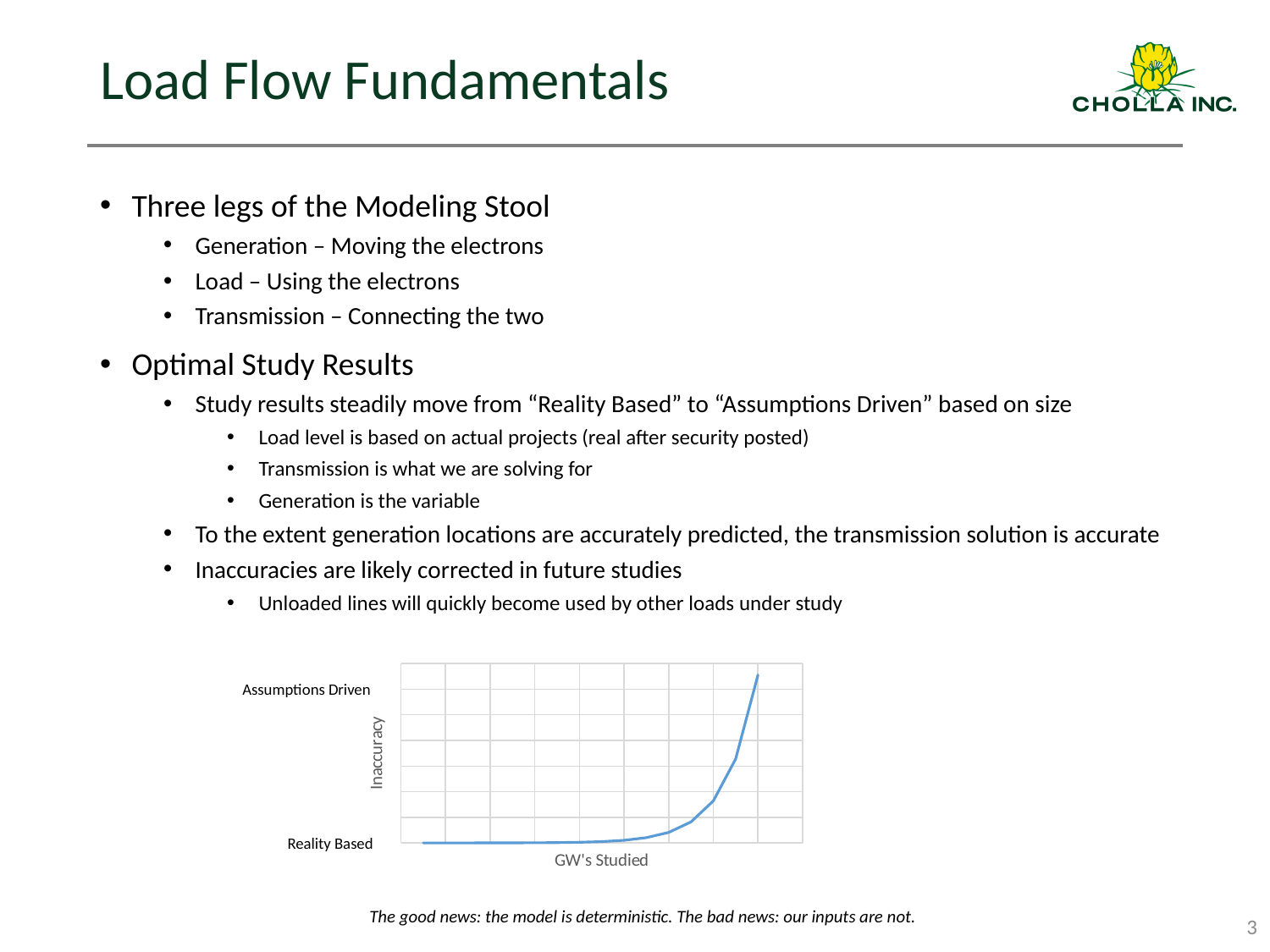
According to the chart, does inaccuracy increase or decrease as more GW's are studied? increase What is the label on the y axis of the chart? Inaccuracy Does the plotted line rise or fall as you move from left to right along the x axis? rise What kind of chart is shown at the bottom of the slide? line chart What is the label on the x axis of the chart? GW's Studied Is the plotted line steeper at the left end or the right end of the chart? right end